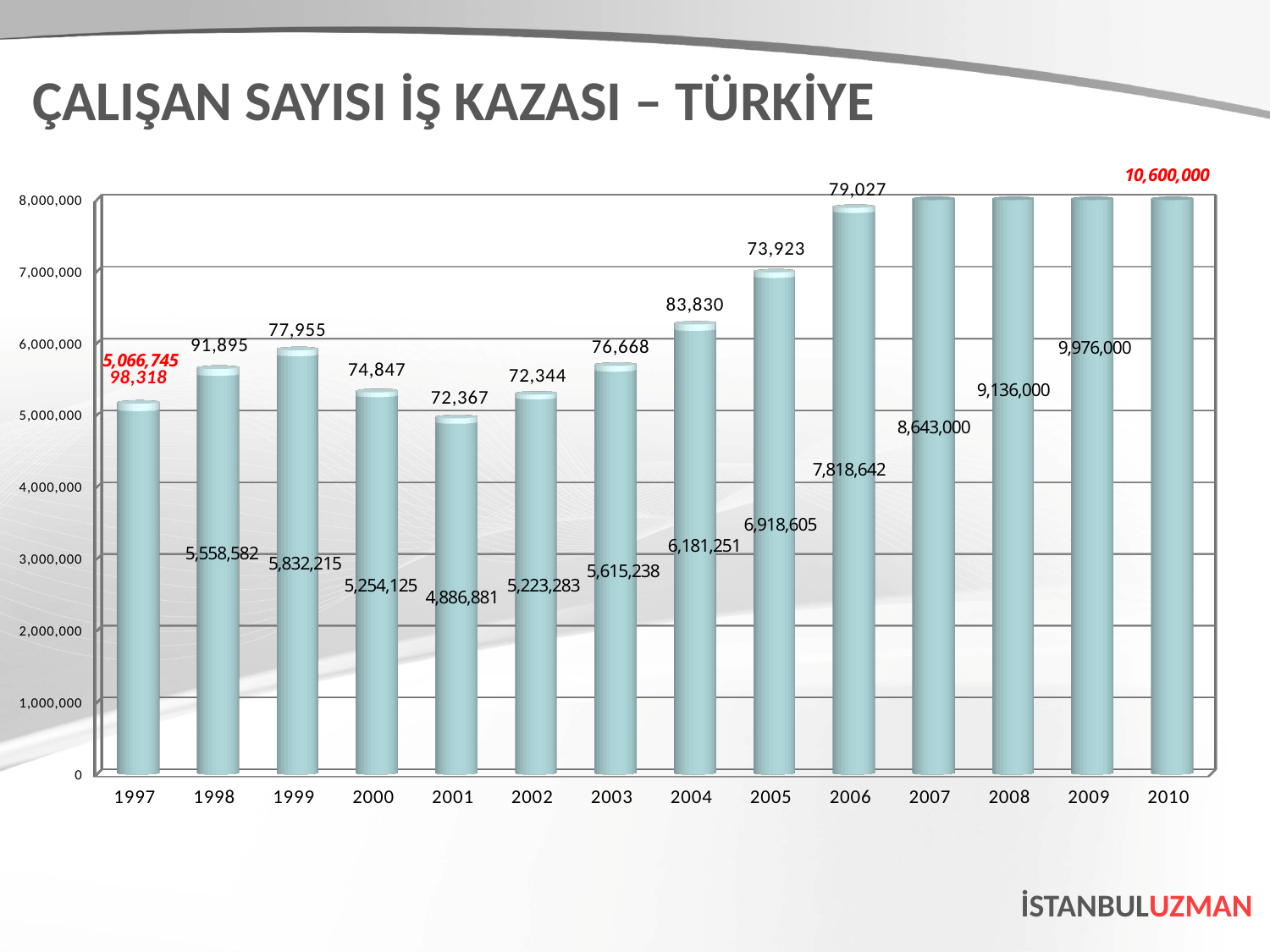
Do the labelled worker numbers rise or fall from 2004 to 2010? rise Which year has the highest labelled number of workers? 2010 What is the number of workers labelled for 2010? 10,600,000 Which year has the lowest labelled number of workers? 2001 Is the number of workers for 2005 greater or less than 6,000,000? greater What is the number of workers (çalışan sayısı) labelled for 2001? 4,886,881 How many years are shown on the x axis of the chart? 14 What is the work accident (iş kazası) figure labelled above the 2004 bar? 83,830 What is the difference between the labelled number of workers in 2010 and in 1997? 5,533,255 Which year has the larger labelled number of workers, 1998 or 1999? 1999 What is the number of workers labelled for 2006? 7,818,642 What kind of chart is shown on the slide? bar chart